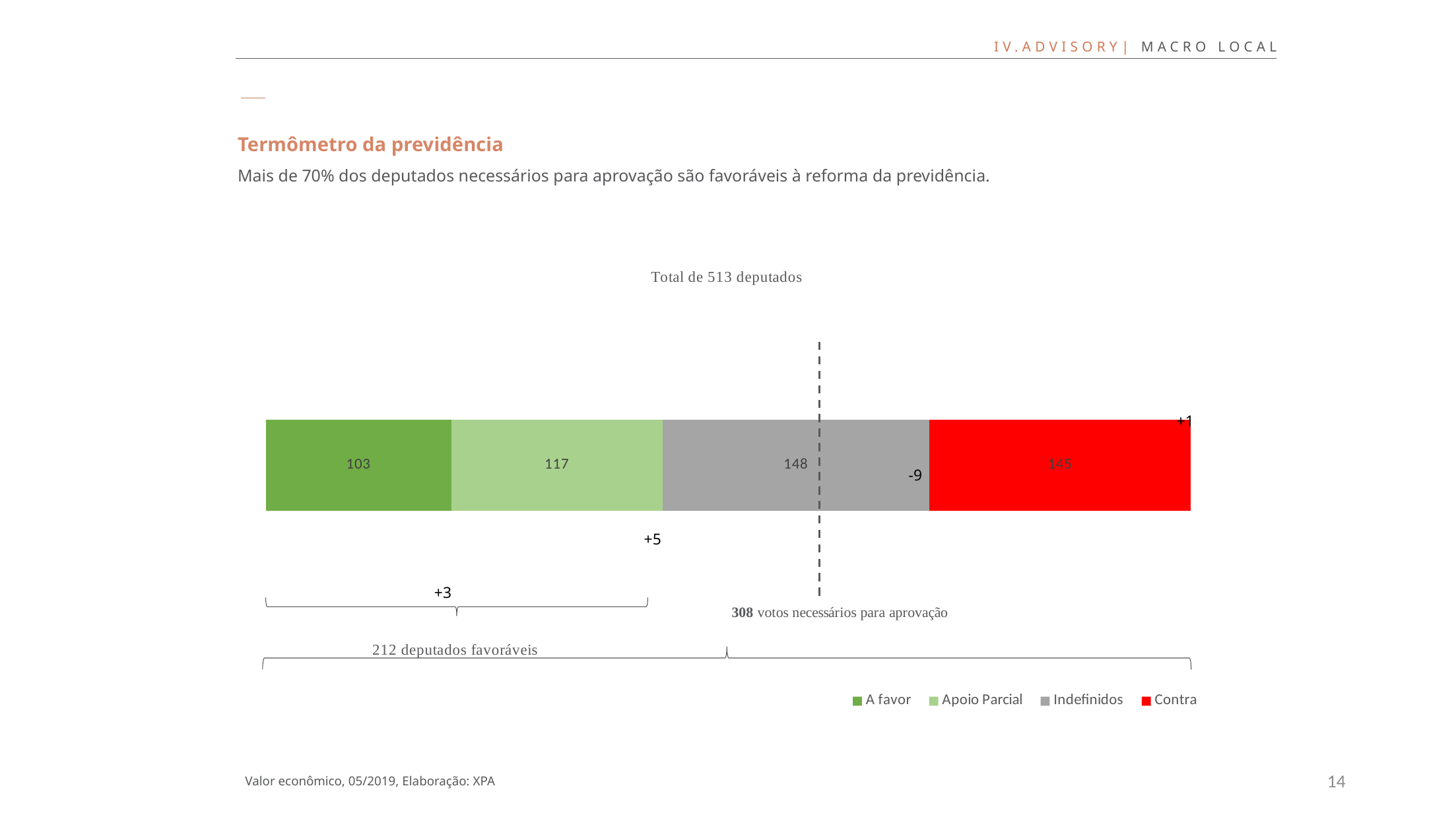
What is the value for the 'Apoio Parcial' segment? 117 Which is larger, the 'Indefinidos' value or the 'Contra' value? Indefinidos Which segment of the bar has the highest value? Indefinidos How many votes are needed for approval according to the dashed line annotation? 308 Which segment of the bar has the lowest value? A favor What is the value for the 'Contra' segment? 145 What is the value for the 'A favor' segment? 103 What is the difference between the 'Apoio Parcial' and 'A favor' values? 14 What kind of chart is shown on the slide? Stacked bar chart What is the value for the 'Indefinidos' segment? 148 What is the total of the stacked bar? 513 How many series does the legend list? 4